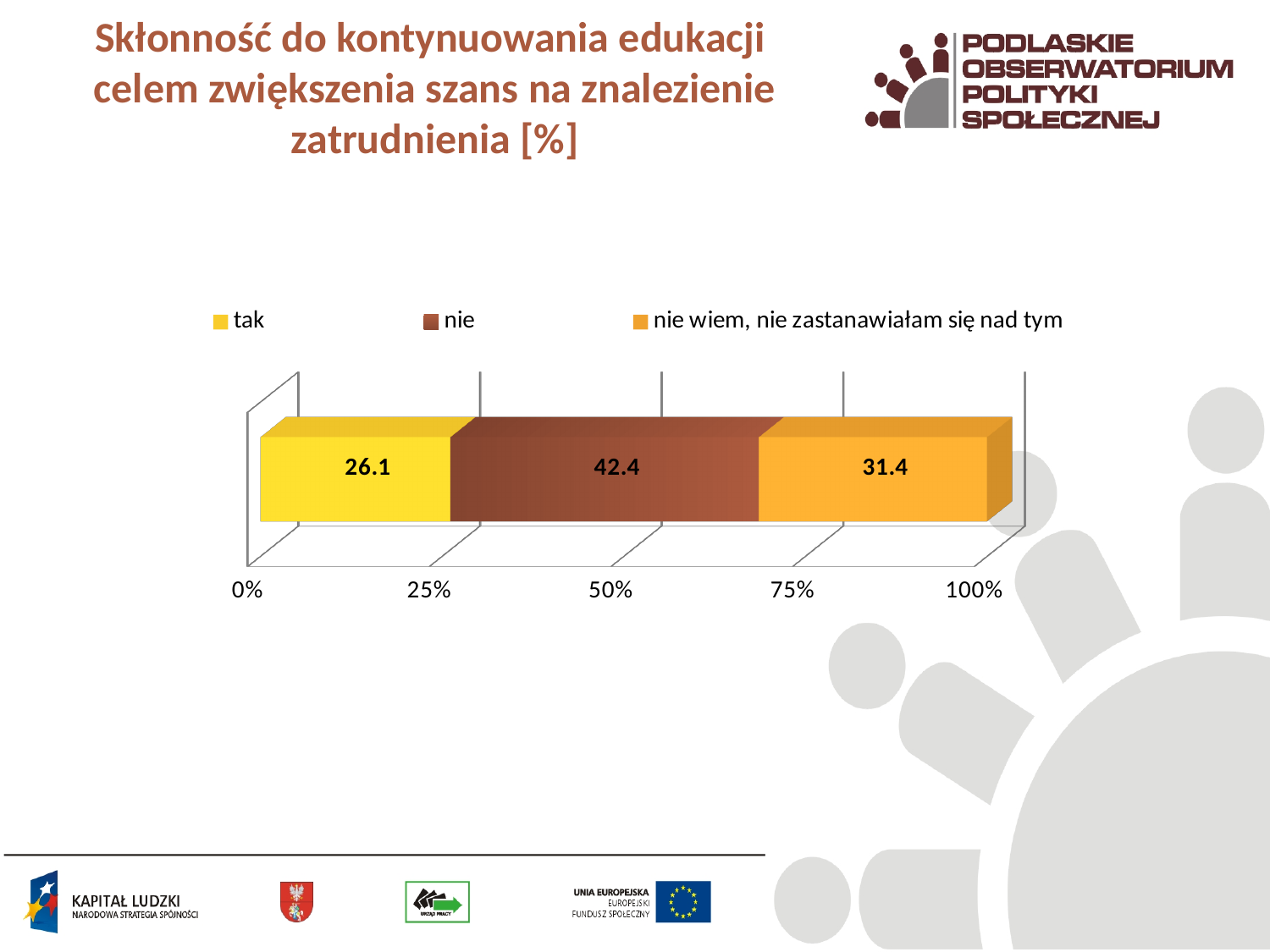
What is the difference between the values for "nie" and "tak"? 16.3 What is the total of the stacked bar? 99.9 What is the value for "tak"? 26.1 How many series does the legend list? 3 Which response has the lowest value? tak What is the highest tick label on the horizontal axis? 100% Which response has the highest value? nie What kind of chart is shown on the slide? stacked bar chart What is the value for "nie wiem, nie zastanawiałam się nad tym"? 31.4 What colour represents "nie" in the chart? brown What is the value for "nie"? 42.4 Which is larger, the value for "nie wiem, nie zastanawiałam się nad tym" or the value for "tak"? nie wiem, nie zastanawiałam się nad tym